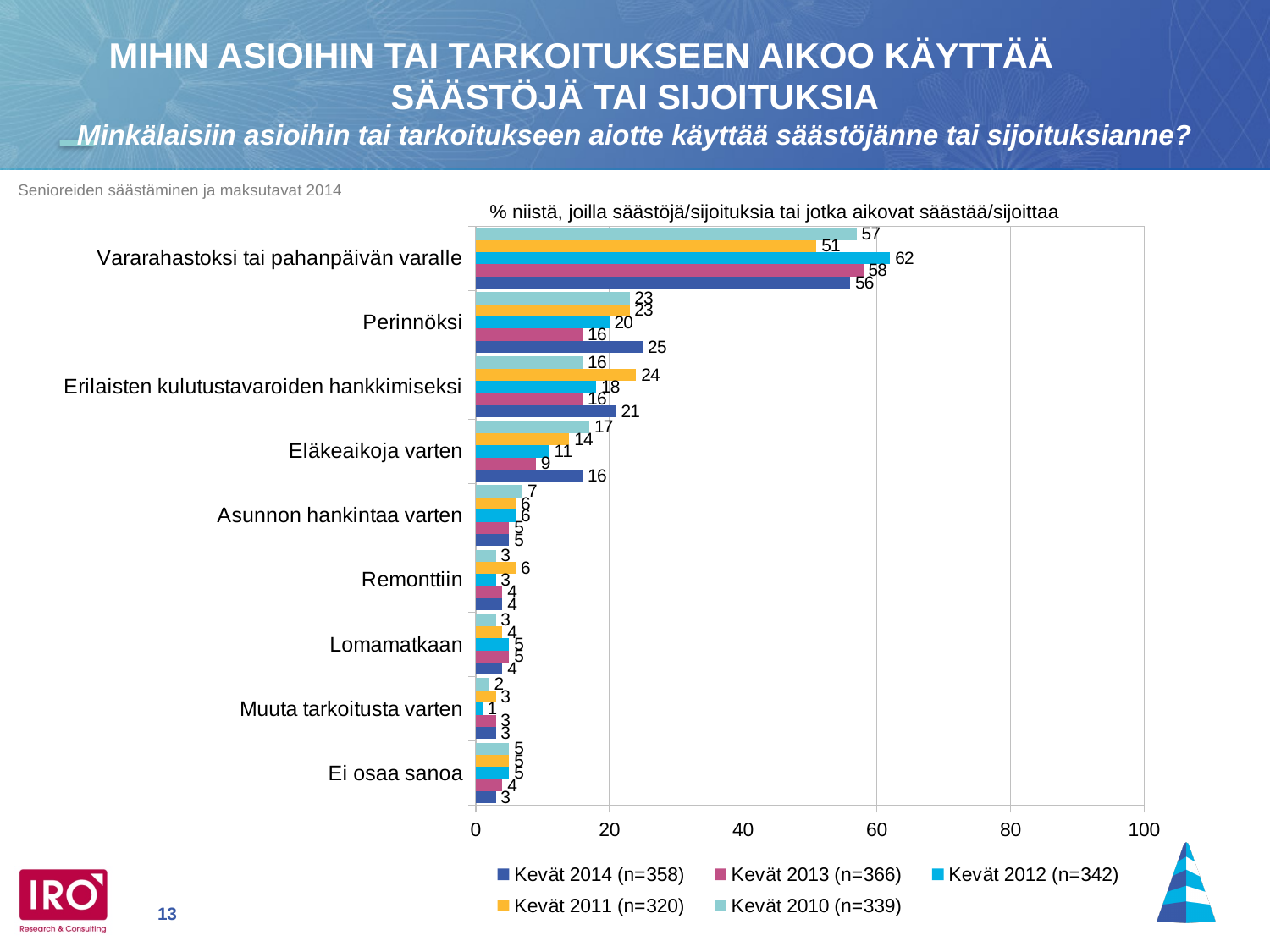
How many categories are shown on the chart? 9 What is the value for Eläkeaikoja varten in the Kevät 2013 (n=366) series? 9 Which category has the highest value in the Kevät 2014 (n=358) series? Vararahastoksi tai pahanpäivän varalle What is the value for Perinnöksi in the Kevät 2014 (n=358) series? 25 Which is larger for Eläkeaikoja varten: the Kevät 2010 (n=339) value or the Kevät 2012 (n=342) value? Kevät 2010 (n=339) What kind of chart is shown on the slide? bar chart What is the value for Erilaisten kulutustavaroiden hankkimiseksi in the Kevät 2011 (n=320) series? 24 What is the difference between the Kevät 2014 (n=358) and Kevät 2013 (n=366) values for Perinnöksi? 9 What is the sample size (n) given in the legend for Kevät 2013? 366 What is the difference between the Kevät 2012 (n=342) and Kevät 2011 (n=320) values for Vararahastoksi tai pahanpäivän varalle? 11 What is the value for Vararahastoksi tai pahanpäivän varalle in the Kevät 2012 (n=342) series? 62 How many series does the legend list? 5